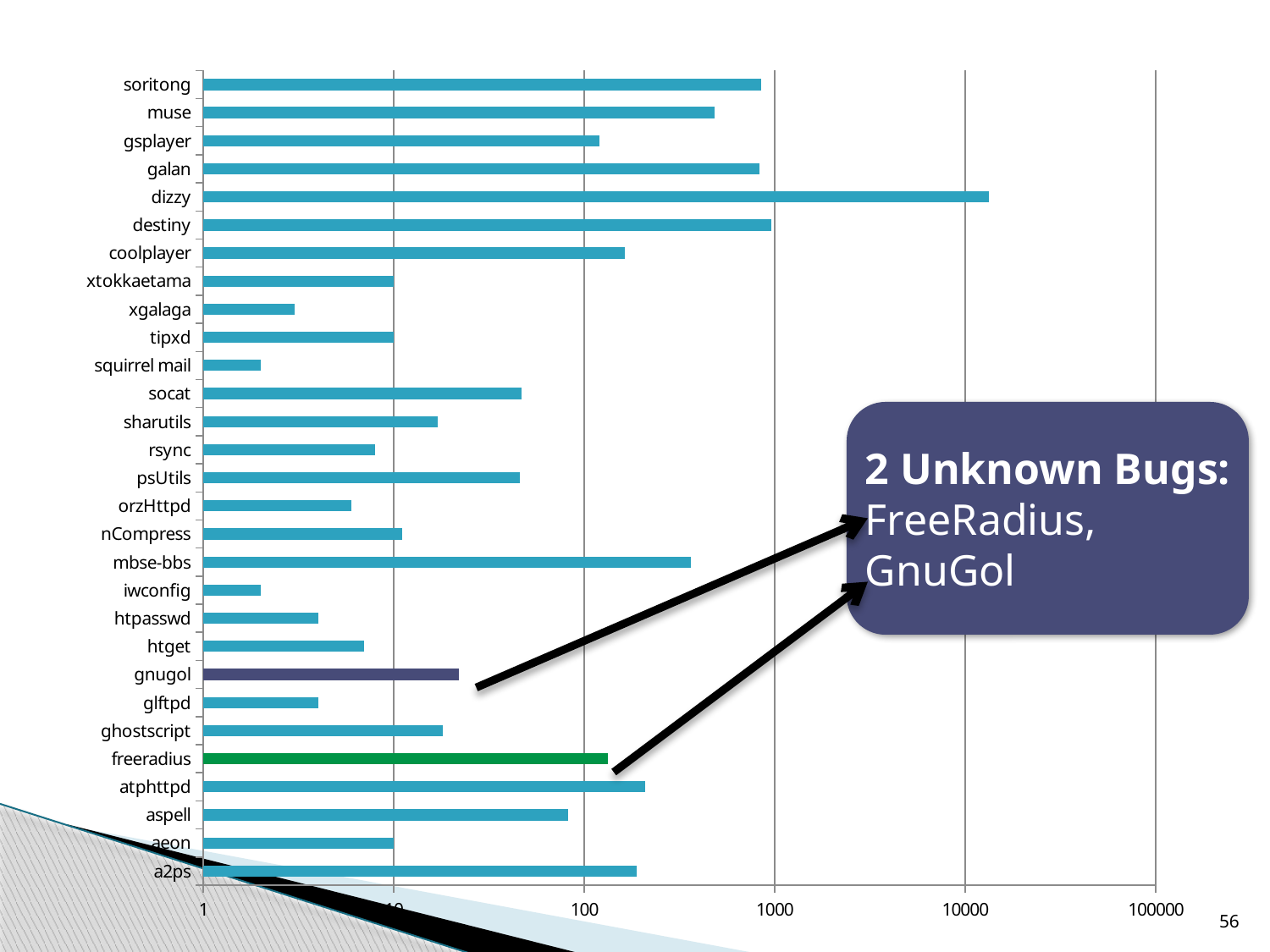
Which category has the highest value on the chart? dizzy Is the value for socat greater or less than 100? less Which two programs does the callout box identify as having unknown bugs? FreeRadius, GnuGol Is the value for soritong greater or less than 100? greater Is the value for mbse-bbs greater or less than 100? greater Which has the larger value, mbse-bbs or socat? mbse-bbs Which has the larger value, dizzy or soritong? dizzy What kind of chart is shown on the slide? bar chart How many categories (programs) are listed on the chart's vertical axis? 29